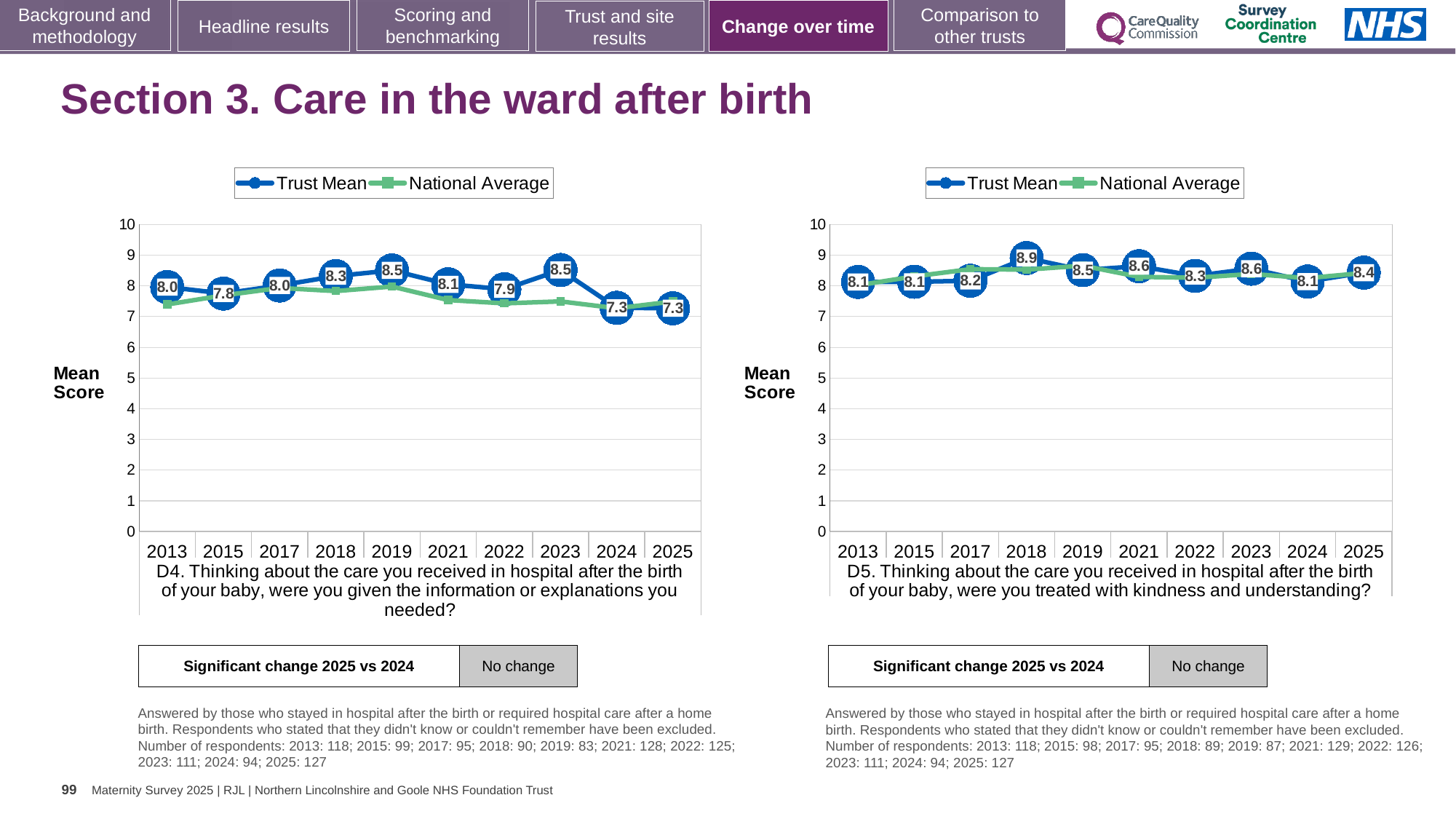
What type of chart is the D5 chart on the right? Line chart In the D4 chart on the left, what is the difference between the Trust Mean scores for 2023 and 2024? 1.2 In the D5 chart on the right, what is the difference between the Trust Mean scores for 2018 and 2024? 0.8 In the D4 chart on the left, what is the Trust Mean score for 2019? 8.5 In the D5 chart on the right, which year has the highest Trust Mean score? 2018 How many years are shown on the x axis of the D5 chart on the right? 10 In the D4 chart on the left, what is the Trust Mean score for 2025? 7.3 In the D4 chart on the left, is the National Average value for 2013 greater or less than 8? less In the D5 chart on the right, what is the Trust Mean score for 2018? 8.9 In the D4 chart on the left, is the Trust Mean score higher in 2018 or in 2022? 2018 In the D5 chart on the right, what is the Trust Mean score for 2025? 8.4 How many series does the legend of the D4 chart on the left list? 2